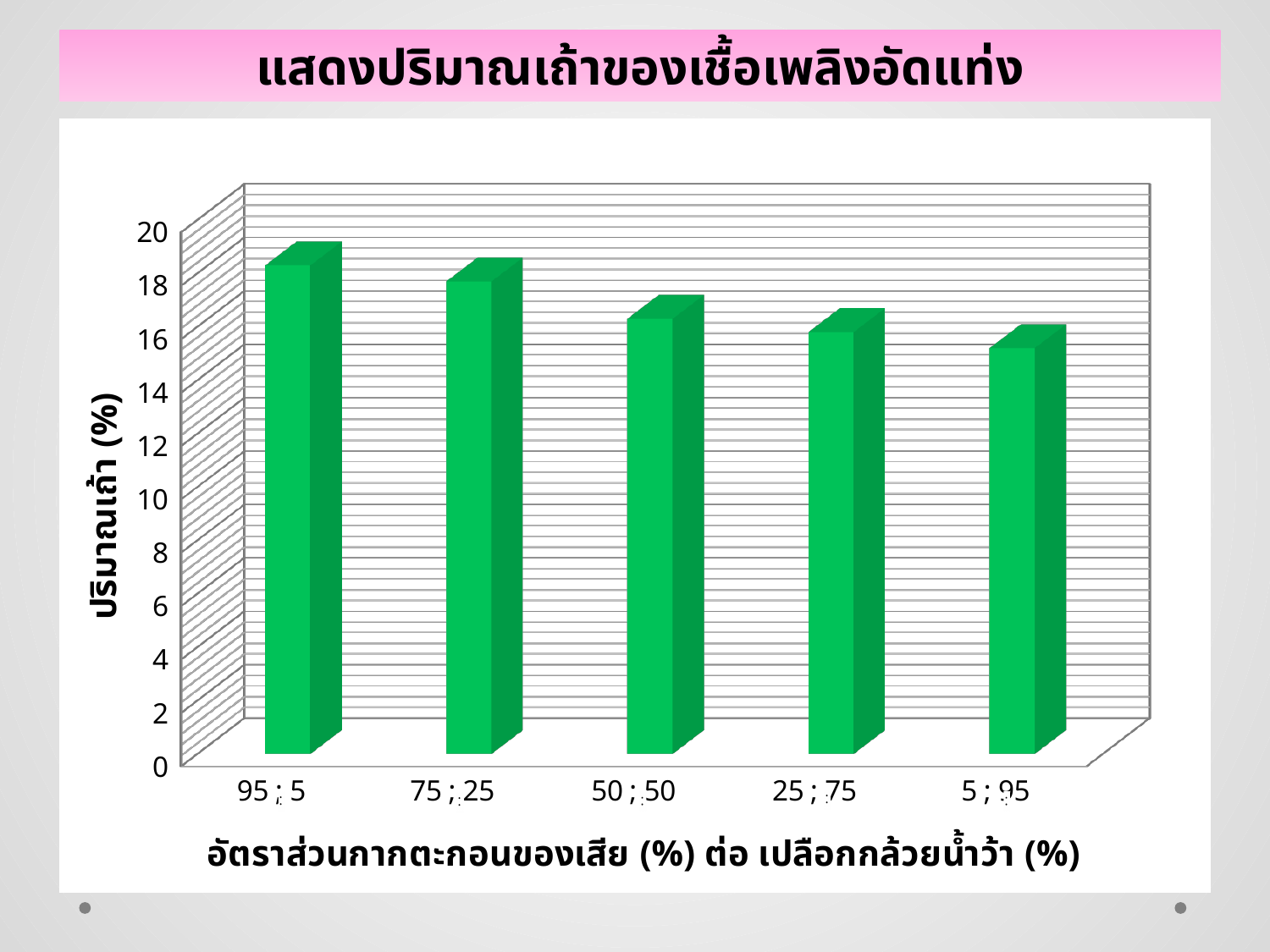
What kind of chart is shown on the slide? bar chart How many categories are shown on the x axis? 5 What is the title of the chart? แสดงปริมาณเถ้าของเชื้อเพลิงอัดแท่ง Is the value for 5 ; 95 greater or less than 18? less Do the values rise or fall moving from left to right along the x axis? fall Is the value for 95 ; 5 greater or less than 16? greater Which is larger, the value for 75 ; 25 or the value for 25 ; 75? 75 ; 25 Is the value for 25 ; 75 greater or less than 18? less Which category has the highest ash content (ปริมาณเถ้า)? 95 ; 5 What is the label of the y axis? ปริมาณเถ้า (%) Which category has the lowest ash content (ปริมาณเถ้า)? 5 ; 95